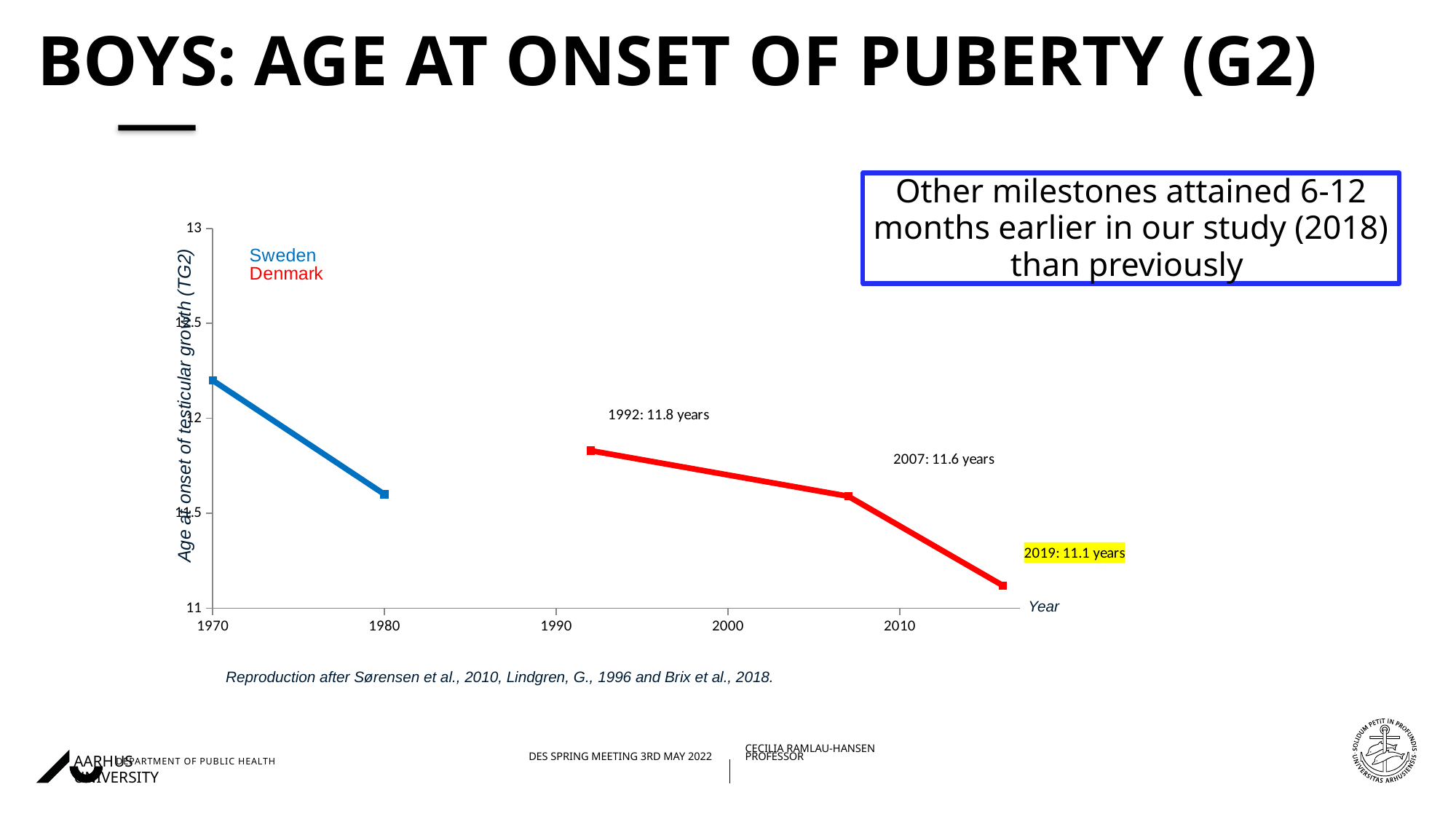
What type of chart is shown on the slide? line chart By how much did the Denmark value fall from 1992 to 2019? 0.7 years Is the Sweden value for 1970 greater or less than 12? greater How many series are shown in the chart? 2 What is the Denmark value for 1992? 11.8 years What is the Denmark value for 2019? 11.1 years What is the Denmark value for 2007? 11.6 years Do the Denmark values rise or fall over time? fall Which of the labelled Denmark points has the lowest value? 2019 Which of the labelled Denmark points has the highest value? 1992 Is the Sweden value for 1980 greater or less than 12? less What is the difference between the Denmark values for 2007 and 2019? 0.5 years